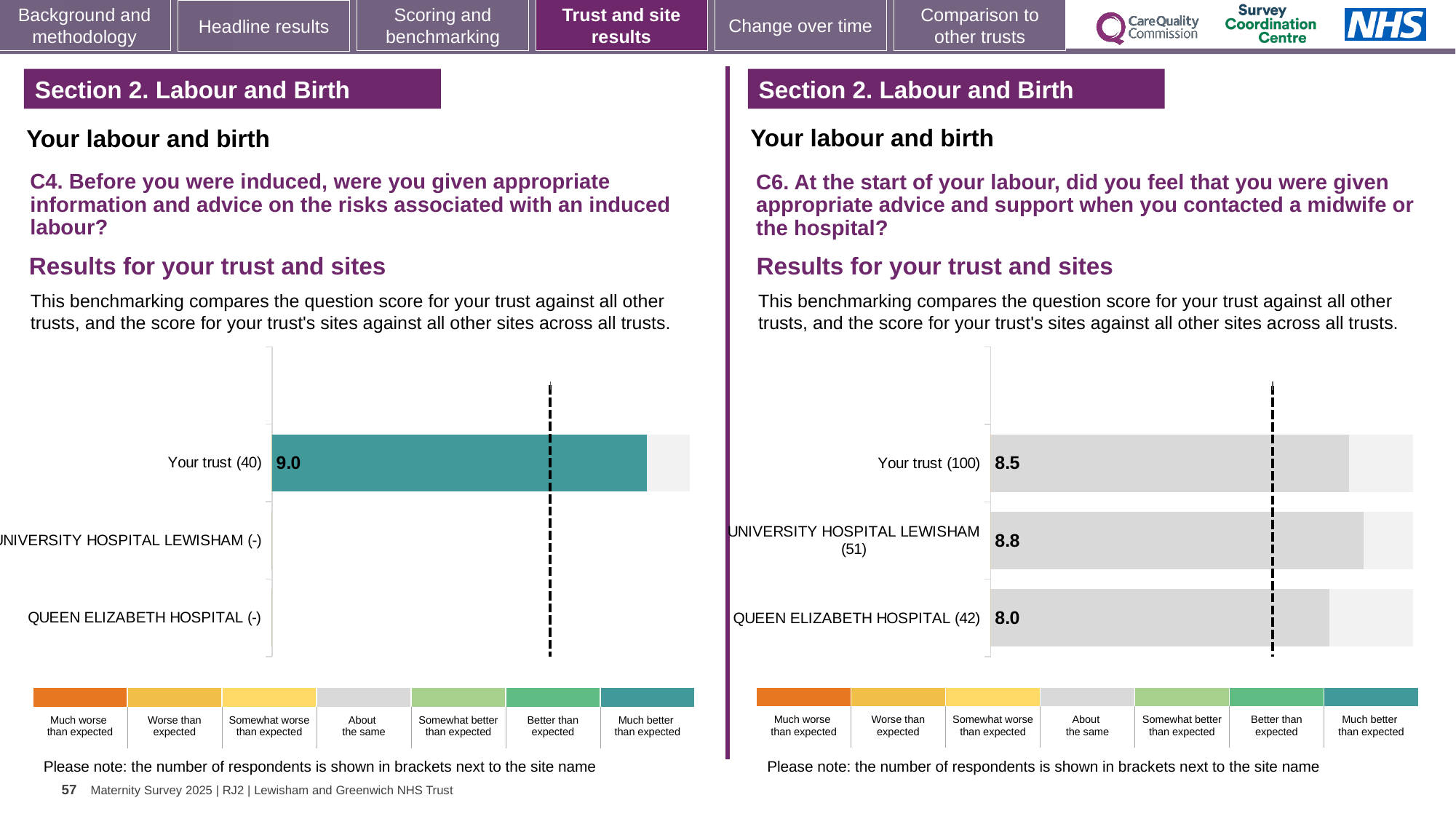
What kind of chart is used on the left (C4) to show the results for your trust and sites? Bar chart On the left chart (C4), what is the score for Your trust? 9.0 On the right chart (C6), how many respondents are shown in brackets for Your trust? 100 On the left chart (C4), which benchmark category does the colour of the Your trust bar correspond to in the legend? Much better than expected On the right chart (C6), what is the score for Your trust? 8.5 On the right chart (C6), what is the difference between the scores for University Hospital Lewisham and Queen Elizabeth Hospital? 0.8 On the right chart (C6), which site or trust has the highest score? University Hospital Lewisham On the right chart (C6), what is the score for University Hospital Lewisham? 8.8 On the left chart (C4), how many respondents are shown in brackets for Your trust? 40 On the right chart (C6), which has the larger score: Your trust or University Hospital Lewisham? University Hospital Lewisham On the right chart (C6), what is the score for Queen Elizabeth Hospital? 8.0 On the right chart (C6), which site or trust has the lowest score? Queen Elizabeth Hospital